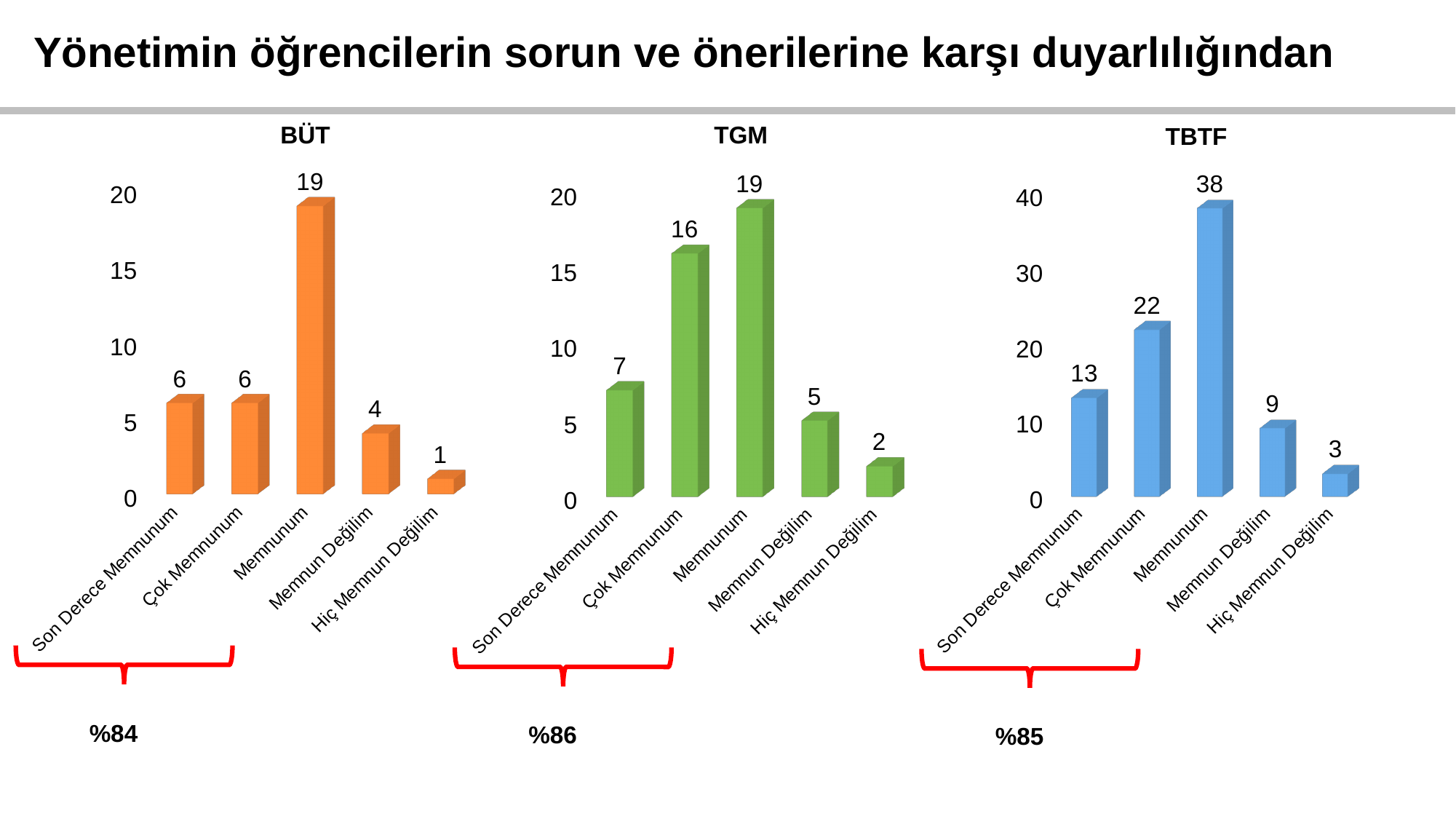
In the TGM chart, which is larger: Son Derece Memnunum or Memnun Değilim? Son Derece Memnunum In the TBTF chart, what is the difference between Memnunum and Çok Memnunum? 16 In the TBTF chart, what is the value for Son Derece Memnunum? 13 In the TBTF chart, what is the total of Memnun Değilim and Hiç Memmun Değilim? 12 In the TGM chart, what is the difference between Memnunum and Çok Memnunum? 3 In the TGM chart, what is the value for Çok Memnunum? 16 What percentage is shown below the TGM chart? %86 How many categories does the BÜT chart show? 5 In the BÜT chart, which category has the lowest value? Hiç Memnun Değilim In the BÜT chart, what is the value for Memnunum? 19 What kind of chart is the TGM chart? bar chart In the TBTF chart, which category has the highest value? Memnunum